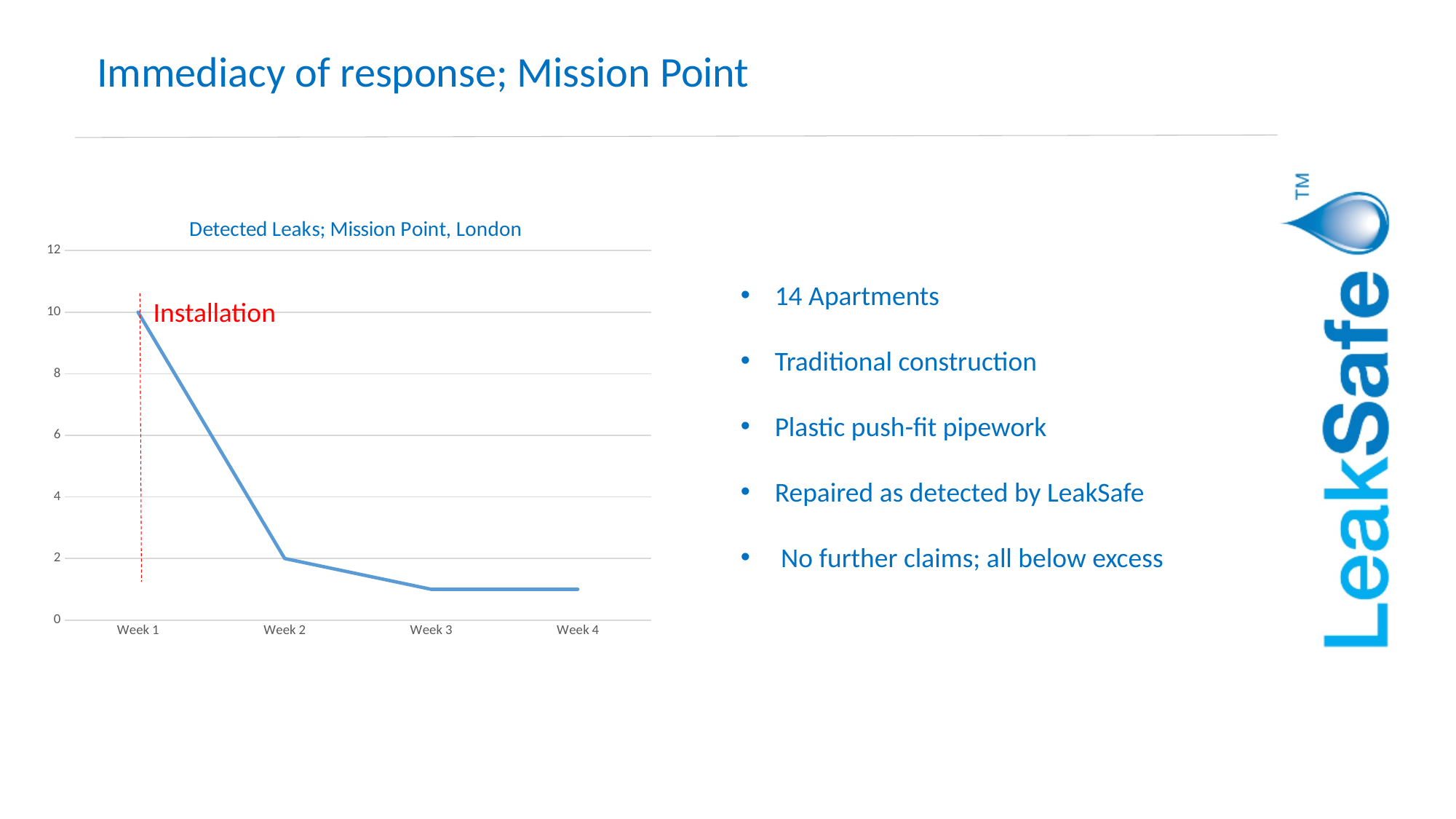
What type of chart is shown on the slide? Line chart Is the value for Week 4 greater or less than 2? less What is the difference in detected leaks between Week 1 and Week 2? 8 What is the number of detected leaks in Week 2? 2 What does the red annotation on the chart at Week 1 say? Installation What is the title of the chart? Detected Leaks; Mission Point, London Which has more detected leaks, Week 1 or Week 2? Week 1 Which week has the highest number of detected leaks? Week 1 How many weeks are plotted on the x axis of the chart? 4 Do the detected leaks rise or fall from Week 1 to Week 4? Fall What is the number of detected leaks in Week 1? 10 Is the value for Week 3 greater or less than 2? less